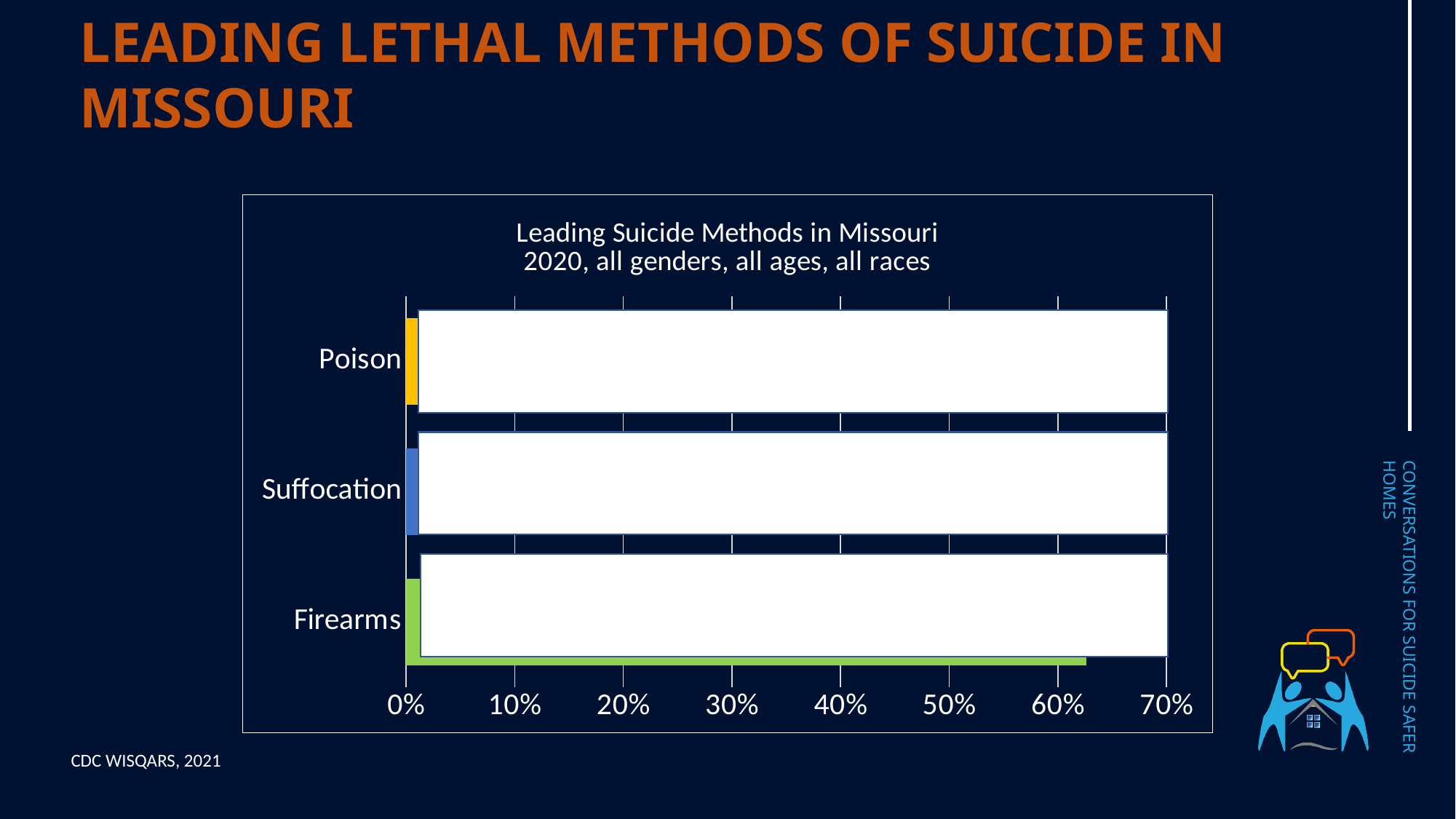
How many suicide methods (categories) are listed on the chart? 3 What kind of chart is shown on the slide? bar chart Is the value for Firearms greater or less than 70%? less What colour is the bar for Firearms? green Is the value for Firearms greater or less than 50%? greater Is the value for Firearms greater or less than 60%? greater What is the title of the chart? Leading Suicide Methods in Missouri 2020, all genders, all ages, all races Which category is listed at the top of the chart? Poison What is the highest value shown on the x axis? 70%